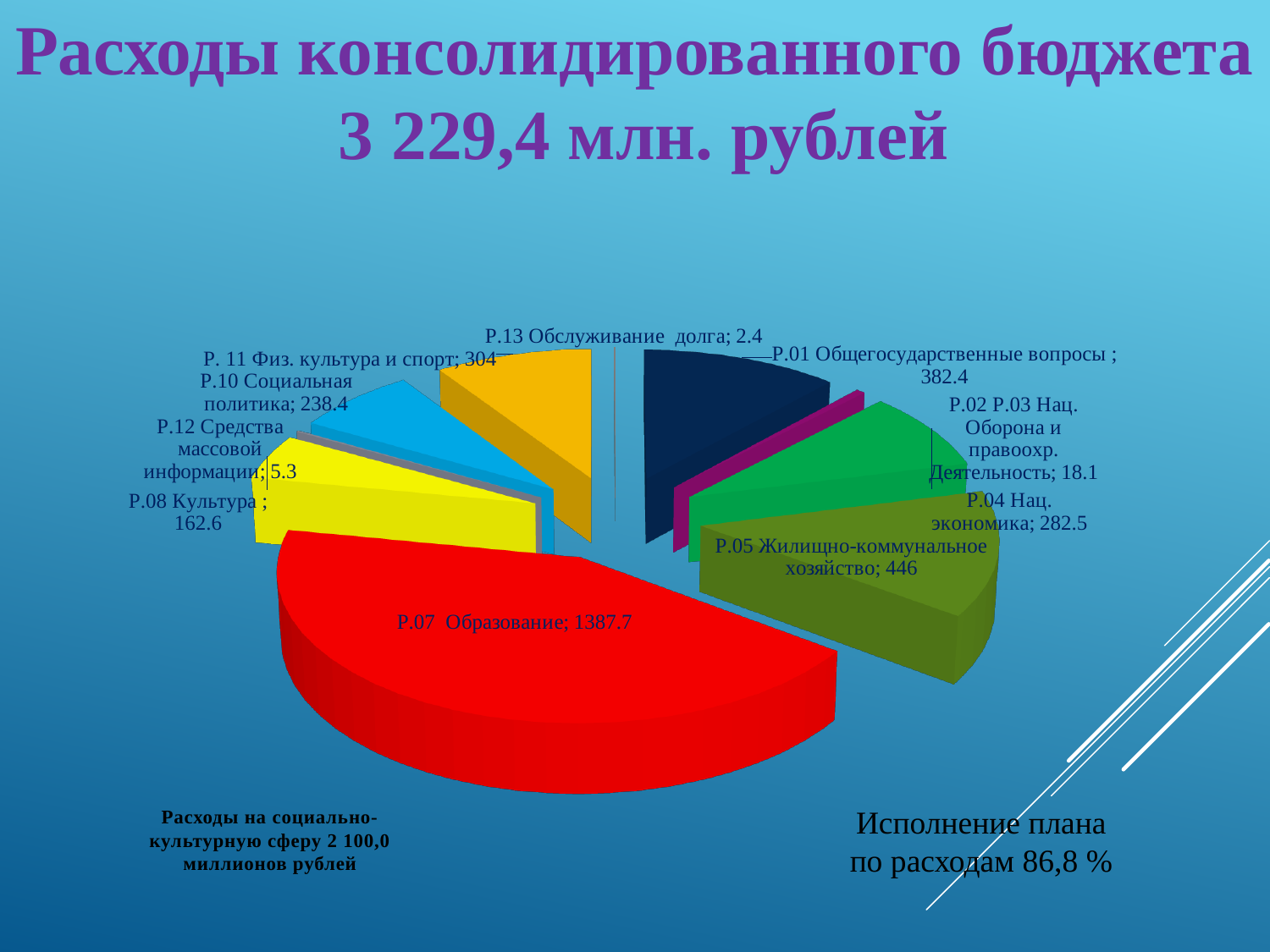
What is the value for Р.13 Обслуживание долга? 2.4 Which category has the largest value? Р.07 Образование What is the difference between the values for Р.05 Жилищно-коммунальное хозяйство and Р.01 Общегосударственные вопросы? 63.6 Which category has the smallest value? Р.13 Обслуживание долга What is the value for Р.07 Образование? 1387.7 What is the value for Р.10 Социальная политика? 238.4 Which is larger: the value for Р. 11 Физ. культура и спорт or the value for Р.04 Нац. экономика? Р. 11 Физ. культура и спорт What is the difference between the values for Р.08 Культура and Р.12 Средства массовой информации? 157.3 How many categories are shown in the pie chart? 10 What is the value for Р.05 Жилищно-коммунальное хозяйство? 446 What is the title of the slide containing the chart? Расходы консолидированного бюджета 3 229,4 млн. рублей What kind of chart is shown on the slide? Pie chart